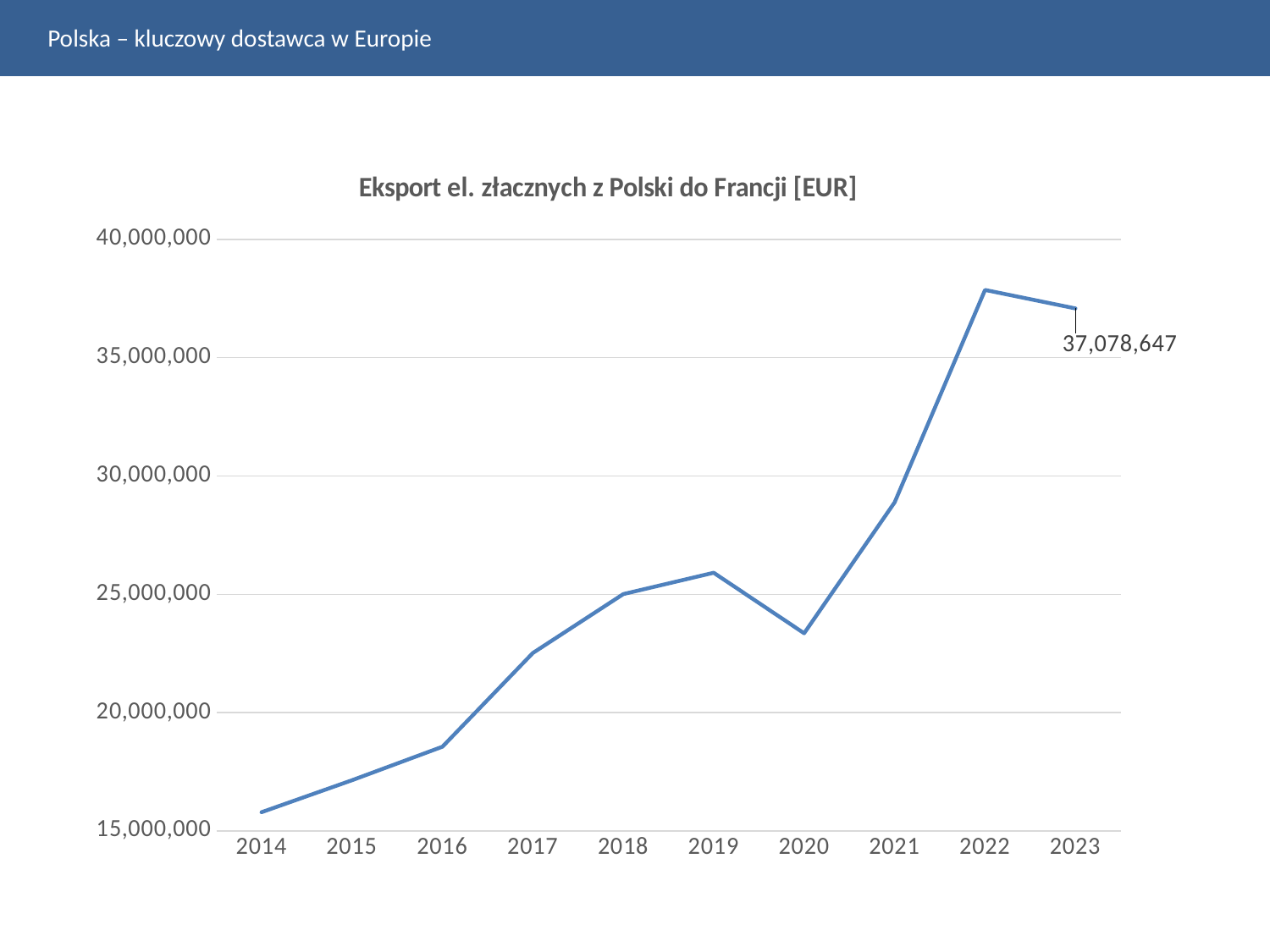
What kind of chart is shown? line chart How many years are plotted on the x axis? 10 Is the value for 2016 greater or less than 20,000,000? less Which is larger, the value for 2019 or the value for 2020? 2019 Which year has the highest value? 2022 What is the value for 2023? 37,078,647 Which year has the lowest value? 2014 Is the value for 2020 greater or less than 25,000,000? less What is the title of the chart? Eksport el. złacznych z Polski do Francji [EUR] Is the value for 2022 greater or less than 35,000,000? greater Which is larger, the value for 2021 or the value for 2017? 2021